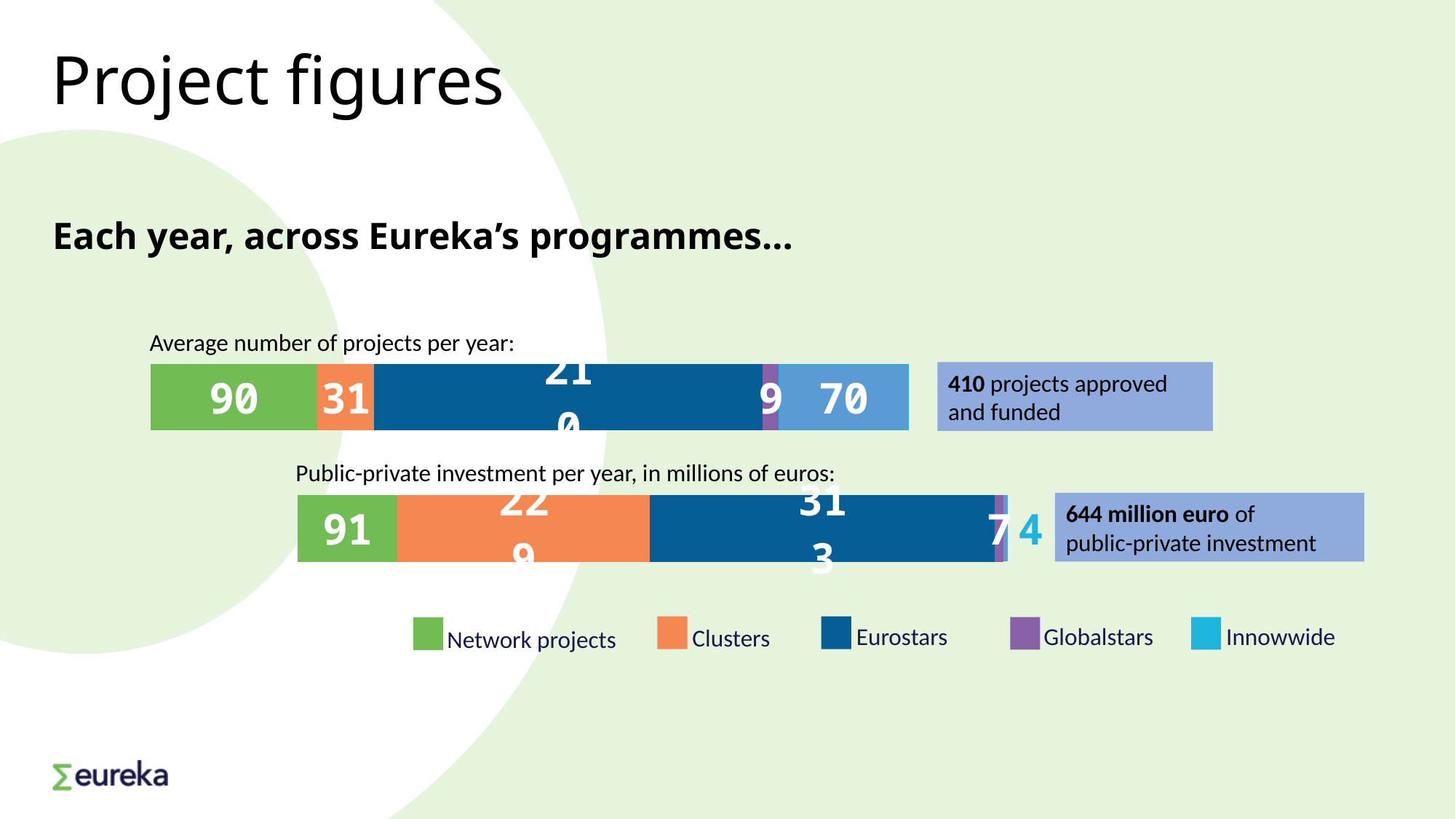
In the 'Average number of projects per year' chart, what is the value for Eurostars? 210 What is the total of the 'Average number of projects per year' stacked bar? 410 How many series does the legend list? 5 In the 'Average number of projects per year' chart, what is the difference between the Eurostars value and the Network projects value? 120 In the 'Public-private investment per year, in millions of euros' chart, what is the value for Eurostars? 313 In the 'Average number of projects per year' chart, which programme has the lowest value? Globalstars In the 'Public-private investment per year, in millions of euros' chart, which programme has the highest value? Eurostars In the 'Average number of projects per year' chart, what is the value for Network projects? 90 In the 'Public-private investment per year, in millions of euros' chart, what is the value for Clusters? 229 In the 'Public-private investment per year, in millions of euros' chart, which is larger: Clusters or Network projects? Clusters In the 'Average number of projects per year' chart, what is the value for Innowwide? 70 What kind of chart is used on this slide? Stacked bar chart